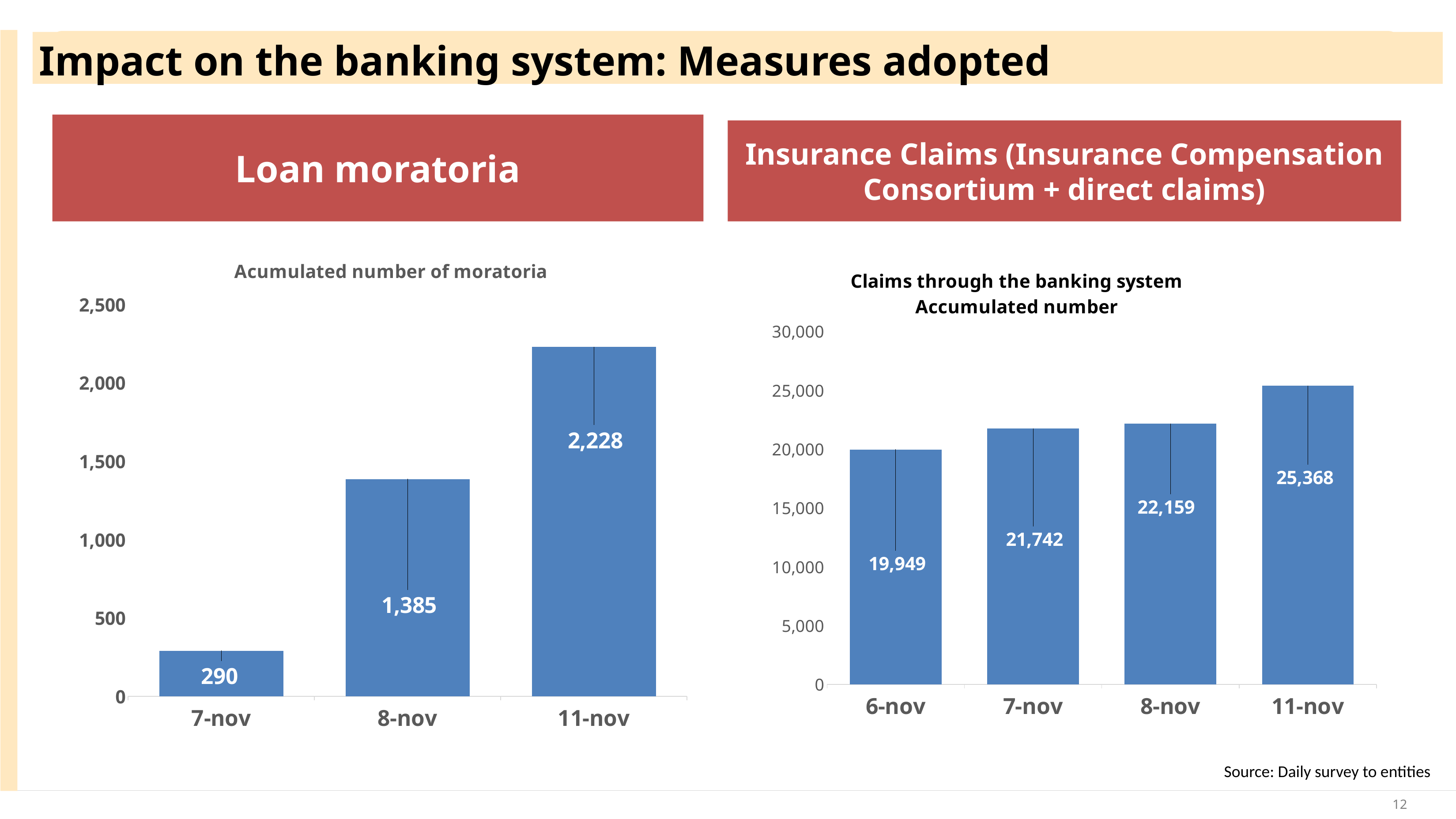
In the 'Acumulated number of moratoria' chart, what is the difference between the values for 11-nov and 8-nov? 843 In the 'Claims through the banking system Accumulated number' chart, what is the value for 8-nov? 22,159 In the 'Acumulated number of moratoria' chart, which date has the lowest value? 7-nov In the 'Acumulated number of moratoria' chart, what is the value for 11-nov? 2,228 In the 'Claims through the banking system Accumulated number' chart, which date has the highest value? 11-nov In the 'Claims through the banking system Accumulated number' chart, what is the difference between the values for 11-nov and 6-nov? 5,419 What kind of chart is the 'Claims through the banking system Accumulated number' chart? bar chart In the 'Claims through the banking system Accumulated number' chart, what is the value for 6-nov? 19,949 In the 'Acumulated number of moratoria' chart, do the values rise or fall from 7-nov to 11-nov? rise In the 'Acumulated number of moratoria' chart, how many dates are shown on the x axis? 3 In the 'Acumulated number of moratoria' chart, what is the value for 8-nov? 1,385 In the 'Claims through the banking system Accumulated number' chart, how many bars are plotted? 4